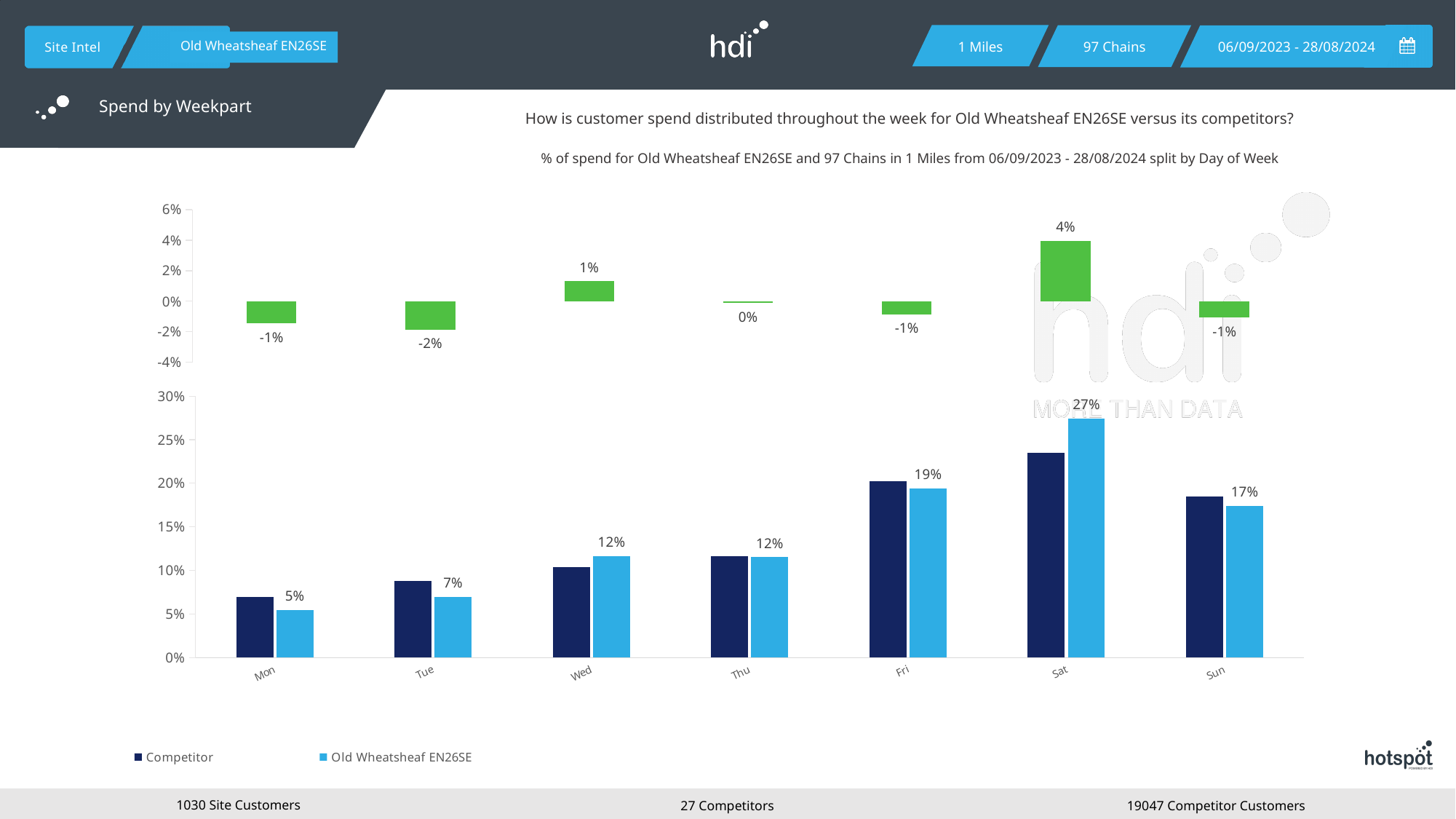
In the bottom chart, is the Competitor value for Sat greater or less than 20%? greater In the top chart, what is the value for Sat? 4% In the bottom chart, what is the value for Old Wheatsheaf EN26SE on Sat? 27% In the bottom chart, what is the difference between the Old Wheatsheaf EN26SE values for Sat and Fri? 8% How many series does the legend of the bottom chart list? 2 In the bottom chart, which day has the lowest value for Old Wheatsheaf EN26SE? Mon In the bottom chart, which day has the highest value for Old Wheatsheaf EN26SE? Sat In the top chart, what is the value for Tue? -2% What kind of chart is the bottom chart? bar chart How many days are shown on the x axis of the bottom chart? 7 In the bottom chart, on Sat, which is larger: the Competitor bar or the Old Wheatsheaf EN26SE bar? Old Wheatsheaf EN26SE In the bottom chart, what is the value for Old Wheatsheaf EN26SE on Mon? 5%